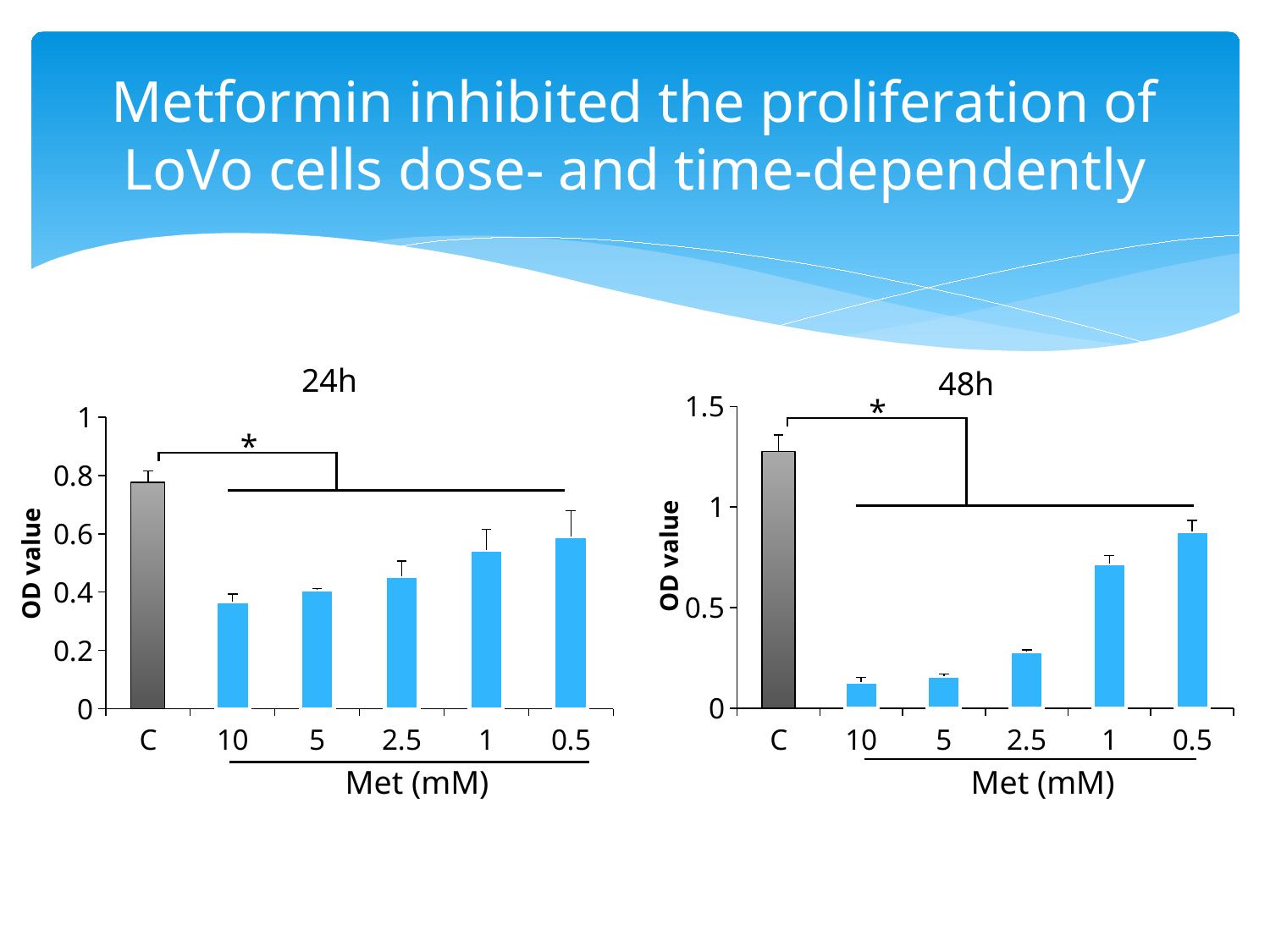
In the 48h chart, which category has the highest OD value? C In the 24h chart, which category has the highest OD value? C In the 24h chart, is the OD value for C greater or less than 0.6? greater In the 24h chart, is the OD value for 10 mM Met greater or less than 0.4? less In the 48h chart, is the OD value for 2.5 mM Met greater or less than 0.5? less What is the y-axis label of the 24h chart? OD value In the 48h chart, do the OD values for the Met doses rise or fall moving from 10 to 0.5 along the x axis? rise How many bars are plotted in the 48h chart? 6 In the 48h chart, which is larger, the OD value for C or for 0.5 mM Met? C What kind of chart is the 24h chart? bar chart In the 24h chart, which category has the lowest OD value? 10